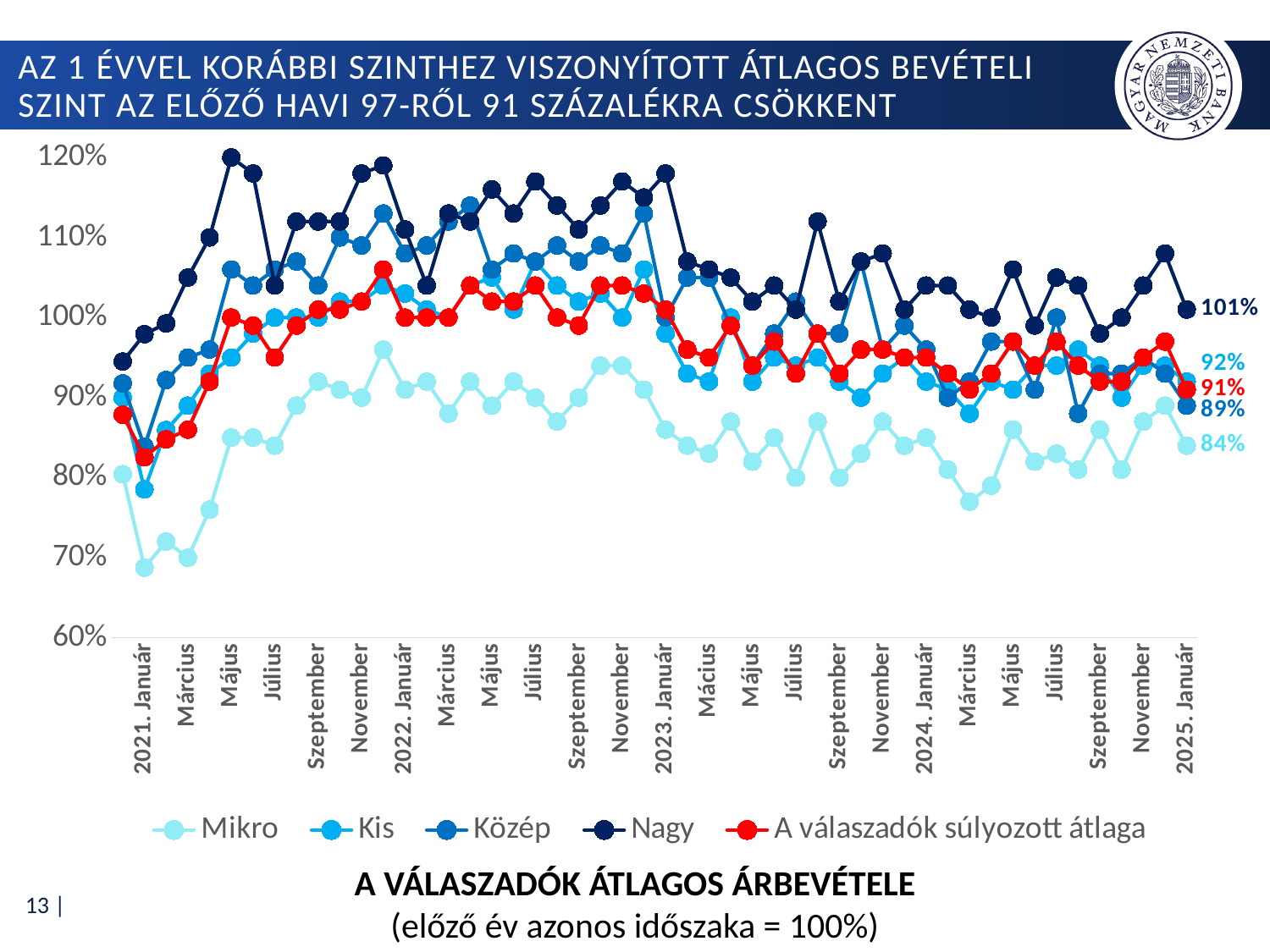
What is the value for Közép at 2025. Január? 89% What is the difference between the Nagy and Mikro values at 2025. Január? 17 percentage points Which series has the highest value at 2025. Január? Nagy Which series has the lowest value at 2025. Január? Mikro At 2025. Január, which is larger: Kis or Közép? Kis What is the value for Nagy at 2025. Január? 101% How many series does the legend list? 5 Which series is drawn in red? A válaszadók súlyozott átlaga What is the value for A válaszadók súlyozott átlaga at 2025. Január? 91% Is the value for Mikro at 2021. Január greater or less than 90%? less What kind of chart is shown on the slide? line chart What is the value for Mikro at 2025. Január? 84%